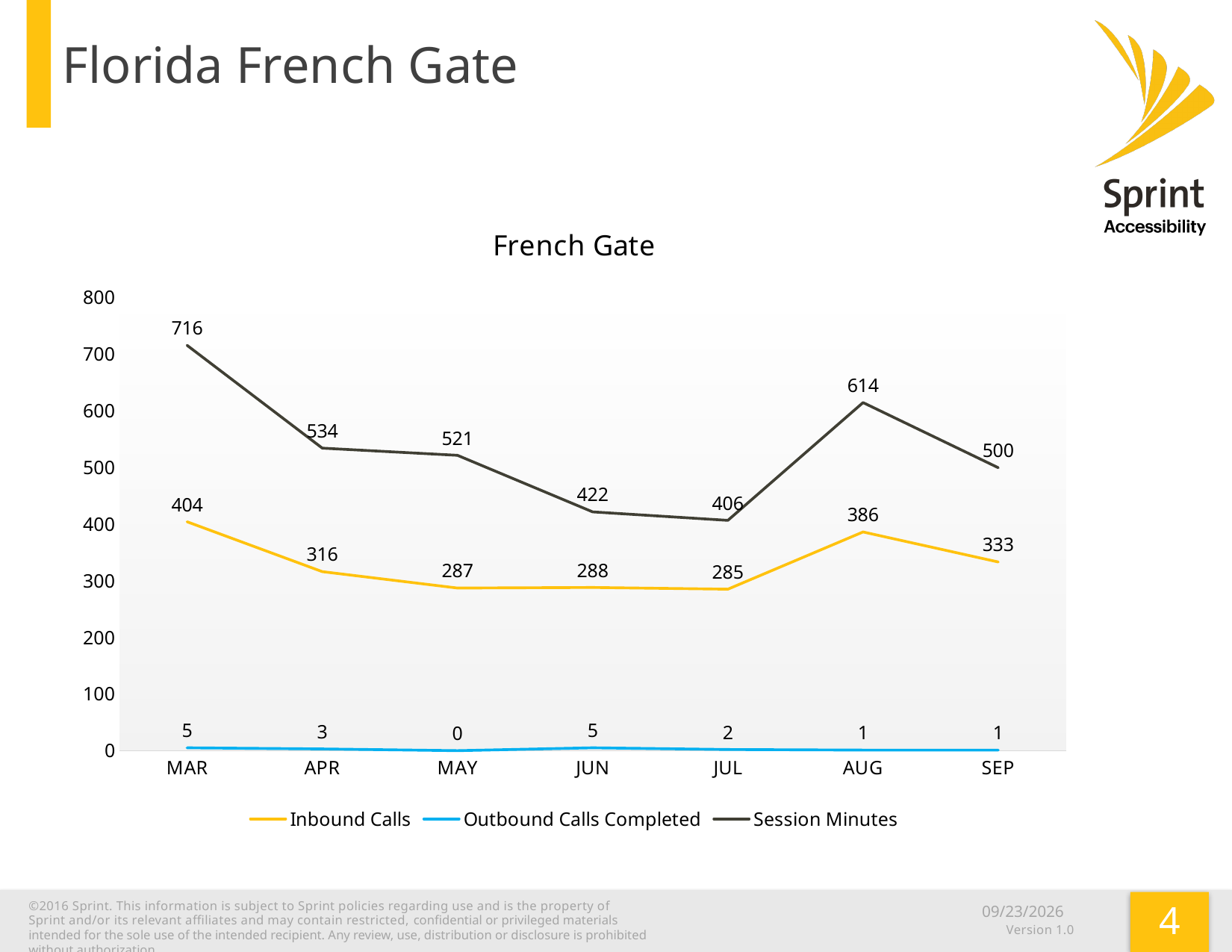
What is the title of the chart? French Gate Do Session Minutes rise or fall from MAR to JUL? Fall What kind of chart is shown? Line chart What is the value of Session Minutes in MAR? 716 How many series does the legend list? 3 What is the value of Outbound Calls Completed in MAY? 0 Which is larger: Inbound Calls in APR or Inbound Calls in SEP? SEP What is the value of Inbound Calls in AUG? 386 In which month are Inbound Calls highest? MAR In which month are Session Minutes lowest? JUL What is the difference between Session Minutes in AUG and in SEP? 114 How many months are shown on the x axis? 7